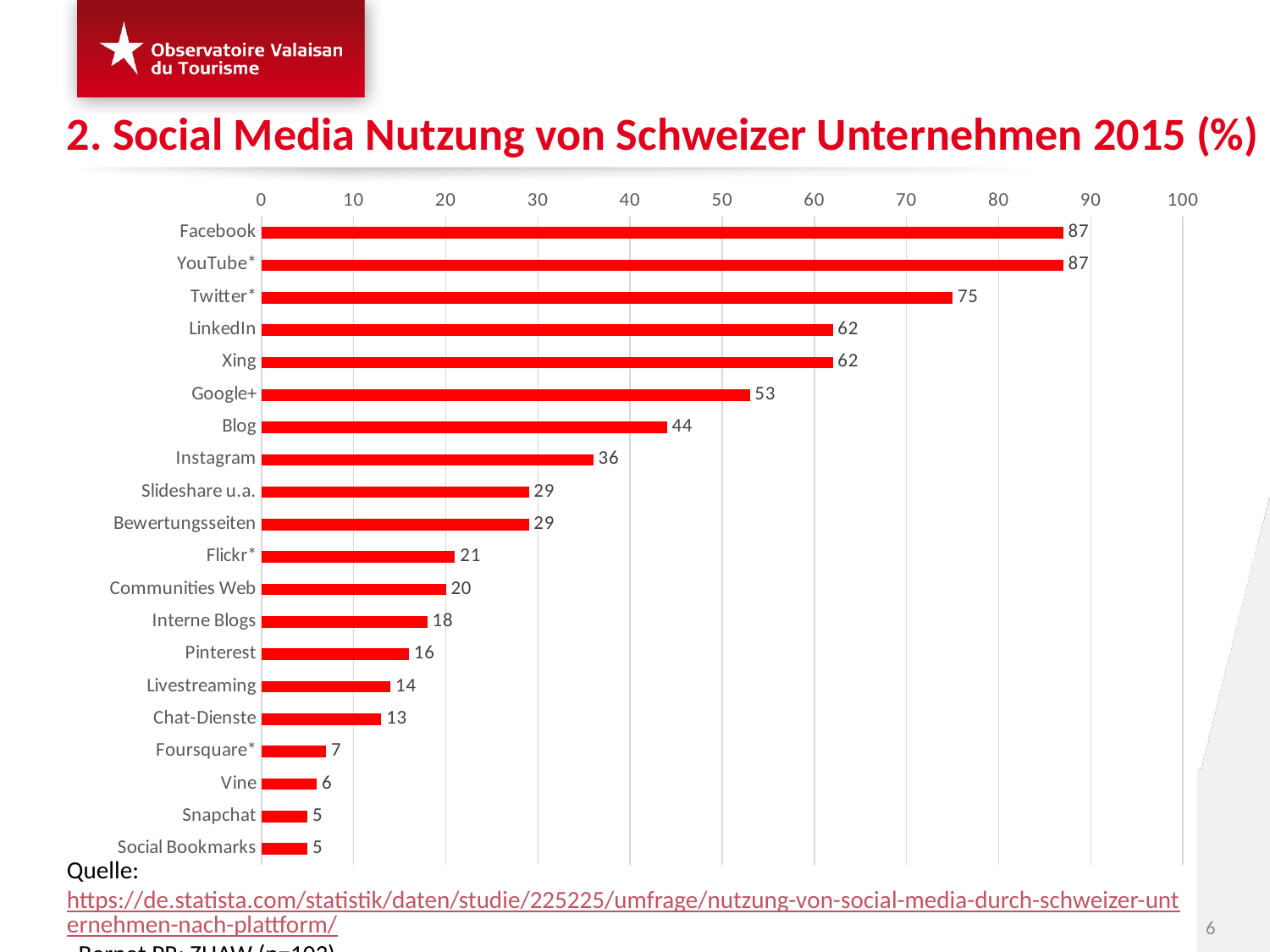
What kind of chart is shown on the slide? bar chart What is the value for Pinterest? 16 What is the value for Twitter*? 75 Is the value for Communities Web greater or less than 30? less What is the value for Instagram? 36 How many categories are shown in the chart? 20 What is the title of the slide? 2. Social Media Nutzung von Schweizer Unternehmen 2015 (%) Which is larger, the value for LinkedIn or the value for Blog? LinkedIn What is the difference between the values for Blog and Flickr*? 23 Which category has the lowest value, Vine or Snapchat? Snapchat Is the value for Google+ greater or less than 50? greater What is the difference between the values for Facebook and Google+? 34